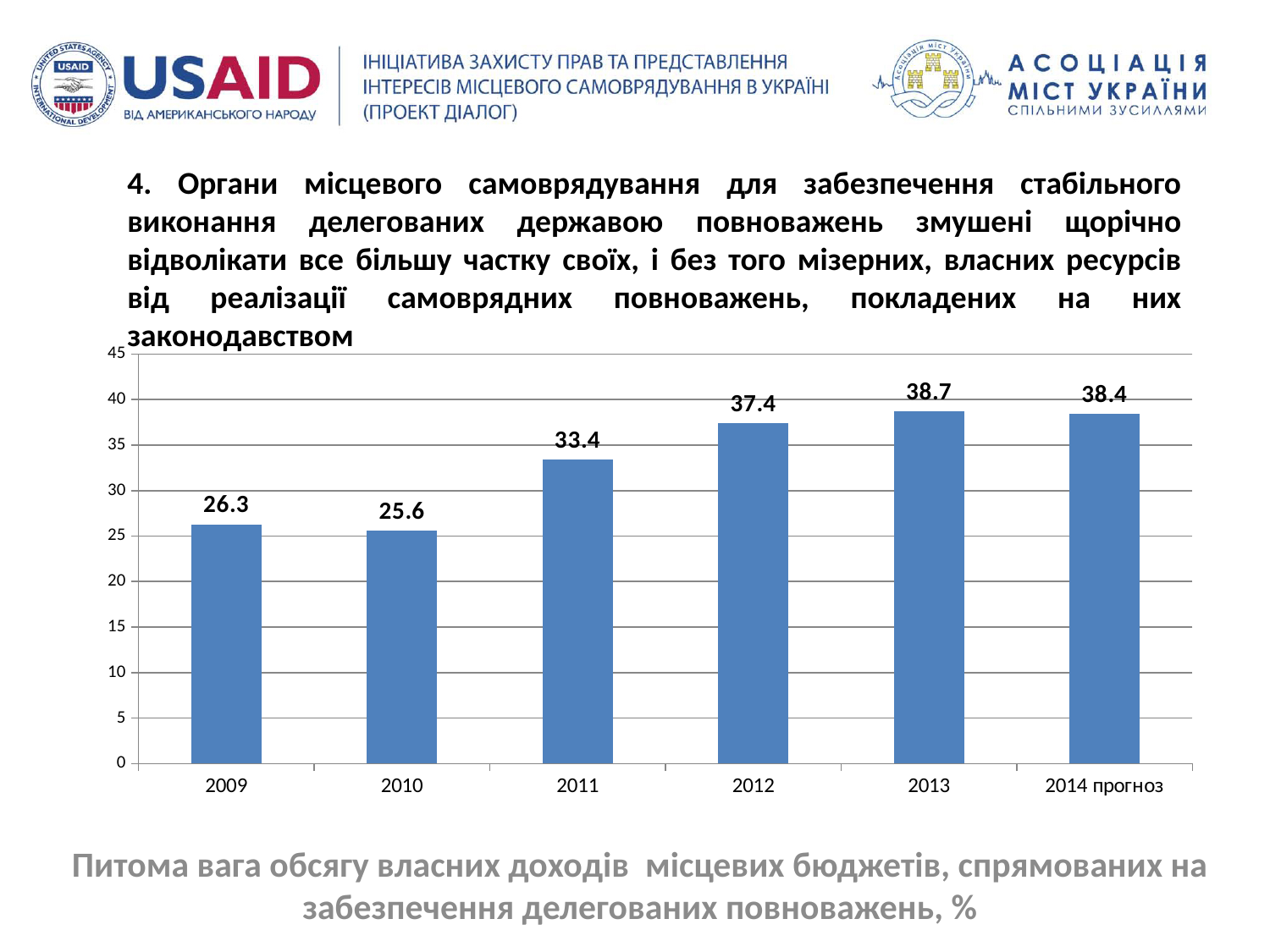
Do the values generally rise or fall from 2010 to 2013? rise What is the value for 2014 прогноз? 38.4 Is the value for 2013 greater or less than 35? greater What is the value for 2009? 26.3 What is the difference between the values for 2013 and 2009? 12.4 How many bars are shown in the chart? 6 What is the difference between the values for 2012 and 2011? 4 Which year has the lowest value? 2010 What kind of chart is shown on the slide? bar chart Which is larger, the value for 2010 or the value for 2012? 2012 What is the value for 2011? 33.4 Which year has the highest value? 2013